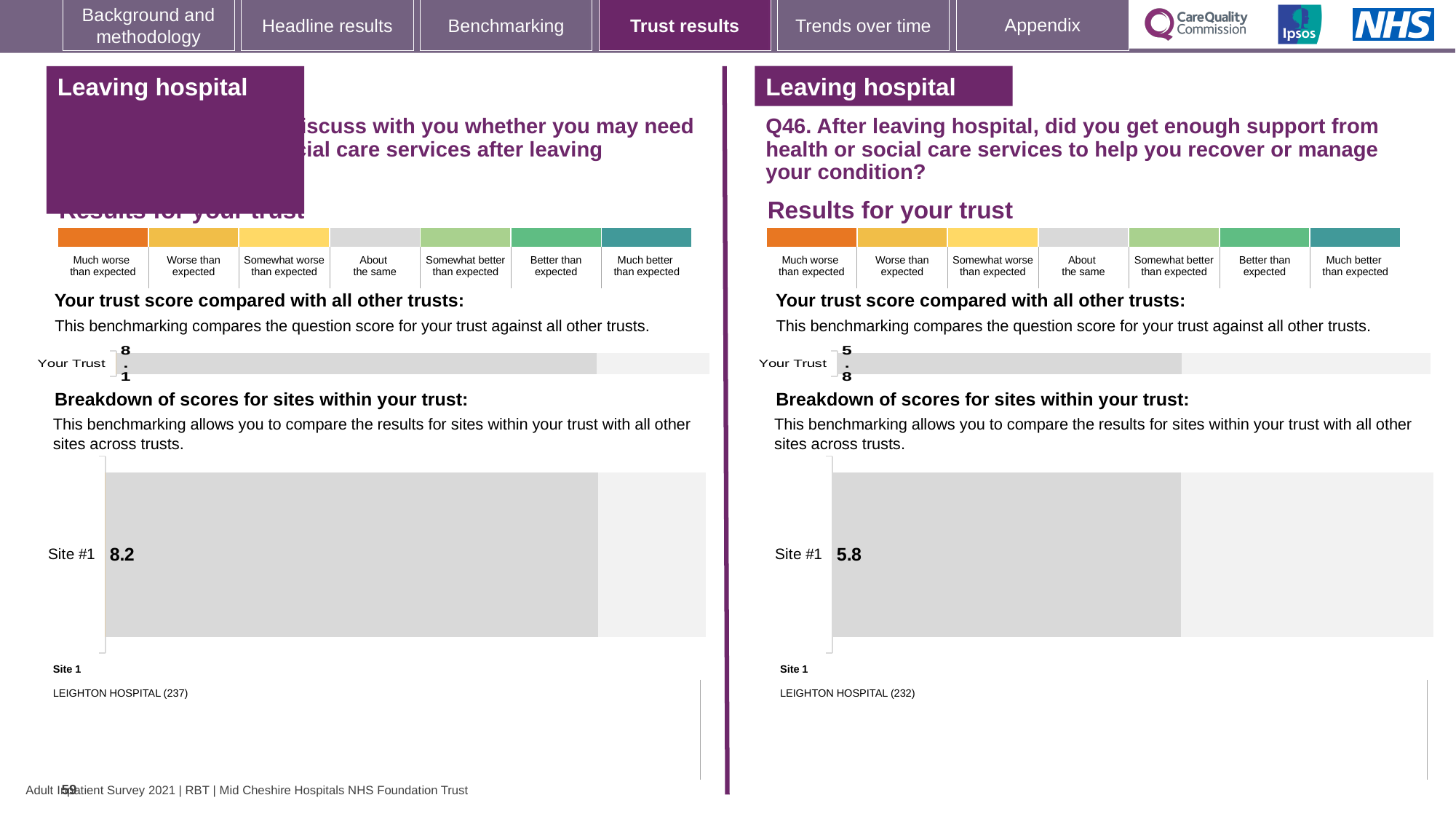
On the left half of the slide, which site name is listed under 'Site 1' below the breakdown chart? LEIGHTON HOSPITAL (237) On the left half of the slide, what score is shown for Site #1 in the 'Breakdown of scores for sites within your trust' chart? 8.2 On the right half of the slide (Q46), what is the score shown for Your Trust in the 'Your trust score compared with all other trusts' chart? 5.8 On the right half of the slide (Q46), which site name is listed under 'Site 1' below the breakdown chart? LEIGHTON HOSPITAL (232) On the right half of the slide (Q46), what score is shown for Site #1 in the 'Breakdown of scores for sites within your trust' chart? 5.8 What type of chart is used to show the Site #1 score on the left half of the slide? Bar chart Is the Your Trust score on the right half of the slide (Q46) greater or less than the Your Trust score on the left half of the slide? less On the left half of the slide, what is the score shown for Your Trust in the 'Your trust score compared with all other trusts' chart? 8.1 What is the difference between the Site #1 score on the left half of the slide (8.2) and the Site #1 score on the right half (5.8)? 2.4 How many sites are shown in the 'Breakdown of scores for sites within your trust' chart on the right half of the slide (Q46)? 1 What is the difference between the Your Trust score on the left half of the slide (8.1) and the Your Trust score on the right half (5.8)? 2.3 Which is larger: the Site #1 score in the left-hand site breakdown chart or the Site #1 score in the right-hand (Q46) site breakdown chart? Left-hand chart (8.2)